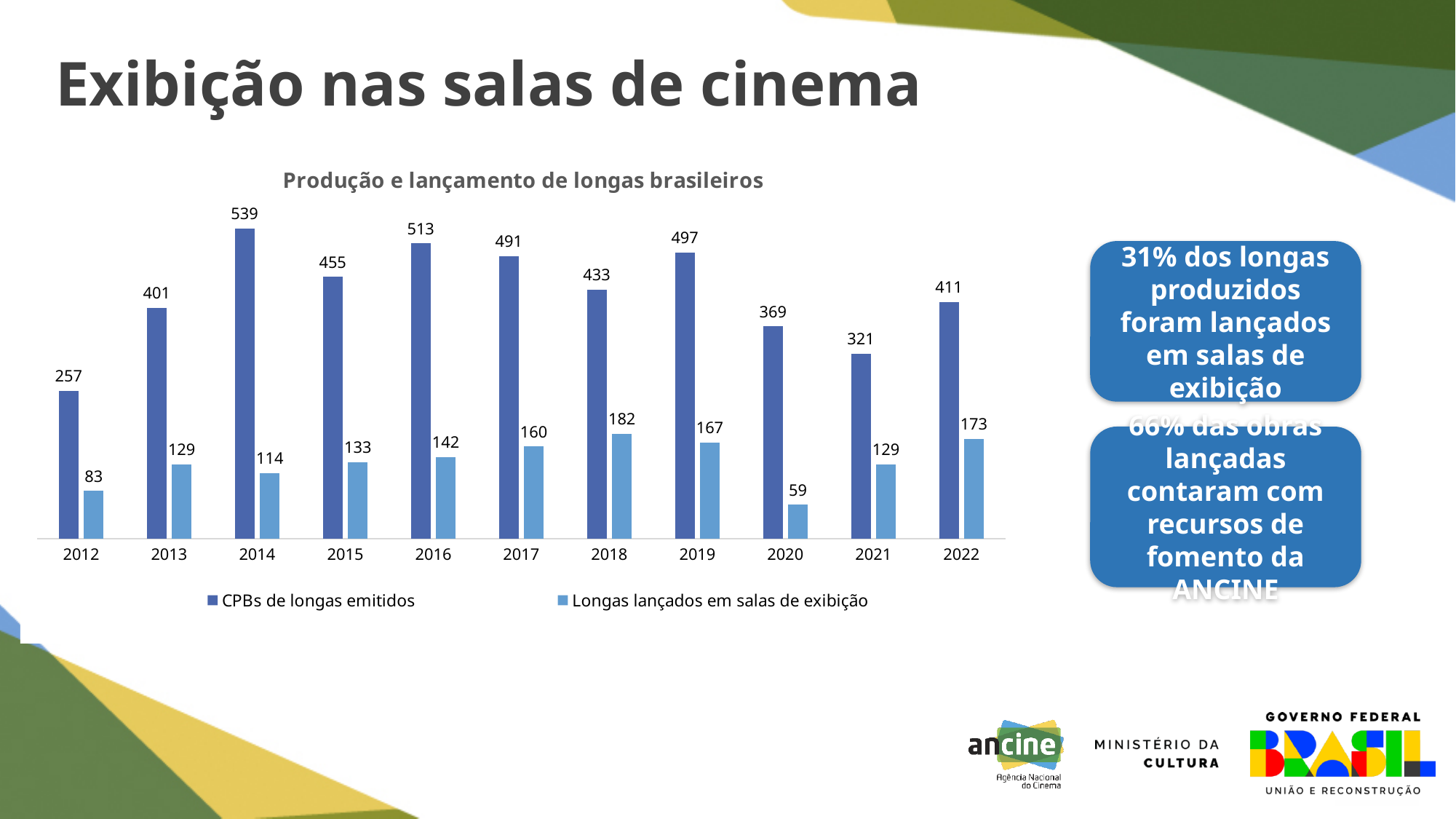
Which year has the highest value for Longas lançados em salas de exibição? 2018 What kind of chart is shown on the slide? bar chart Did the value of CPBs de longas emitidos rise or fall from 2019 to 2021? fall What is the value of CPBs de longas emitidos for 2014? 539 How many years are shown on the x axis of the chart? 11 Which is larger: Longas lançados em salas de exibição in 2018 or in 2019? 2018 What is the difference between CPBs de longas emitidos and Longas lançados em salas de exibição in 2022? 238 How many series does the chart legend list? 2 Which year has the lowest value for Longas lançados em salas de exibição? 2020 What is the value of Longas lançados em salas de exibição for 2020? 59 What is the title of the chart? Produção e lançamento de longas brasileiros Which year has the highest value for CPBs de longas emitidos? 2014